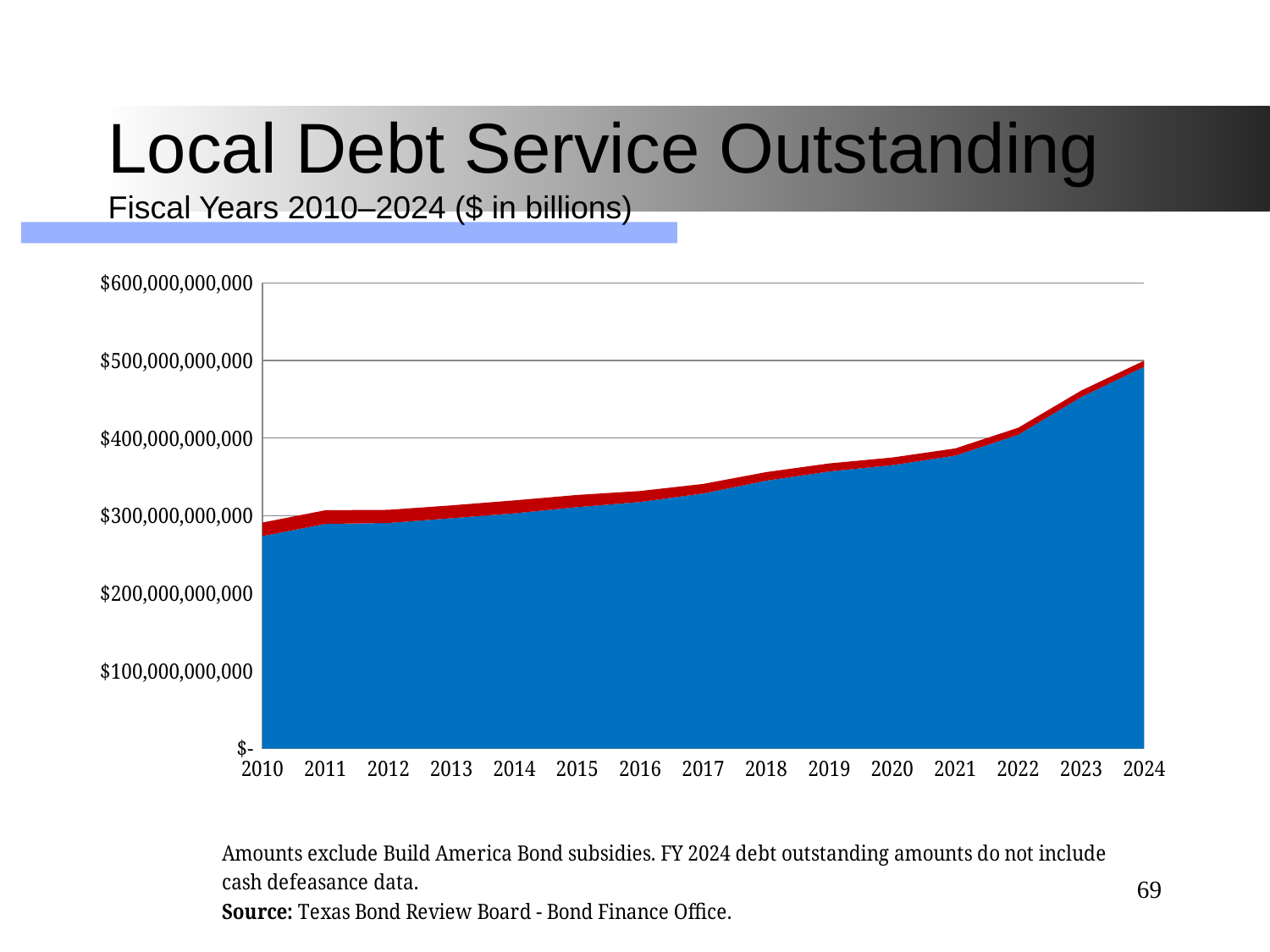
What is the title of the chart on the slide? Local Debt Service Outstanding What kind of chart is shown on the slide? Area chart Is the total value for 2021 greater or less than $400,000,000,000? less Is the total value for 2015 greater or less than $300,000,000,000? greater Which fiscal year has the lowest total local debt service outstanding? 2010 Is the total value for 2024 greater or less than $400,000,000,000? greater Which fiscal year has the highest total local debt service outstanding? 2024 Do the values generally rise or fall from 2010 to 2024? Rise Which is larger, the total value for 2023 or the total value for 2018? 2023 How many stacked series (colored areas) are shown in the chart? 2 How many fiscal years are plotted along the x axis? 15